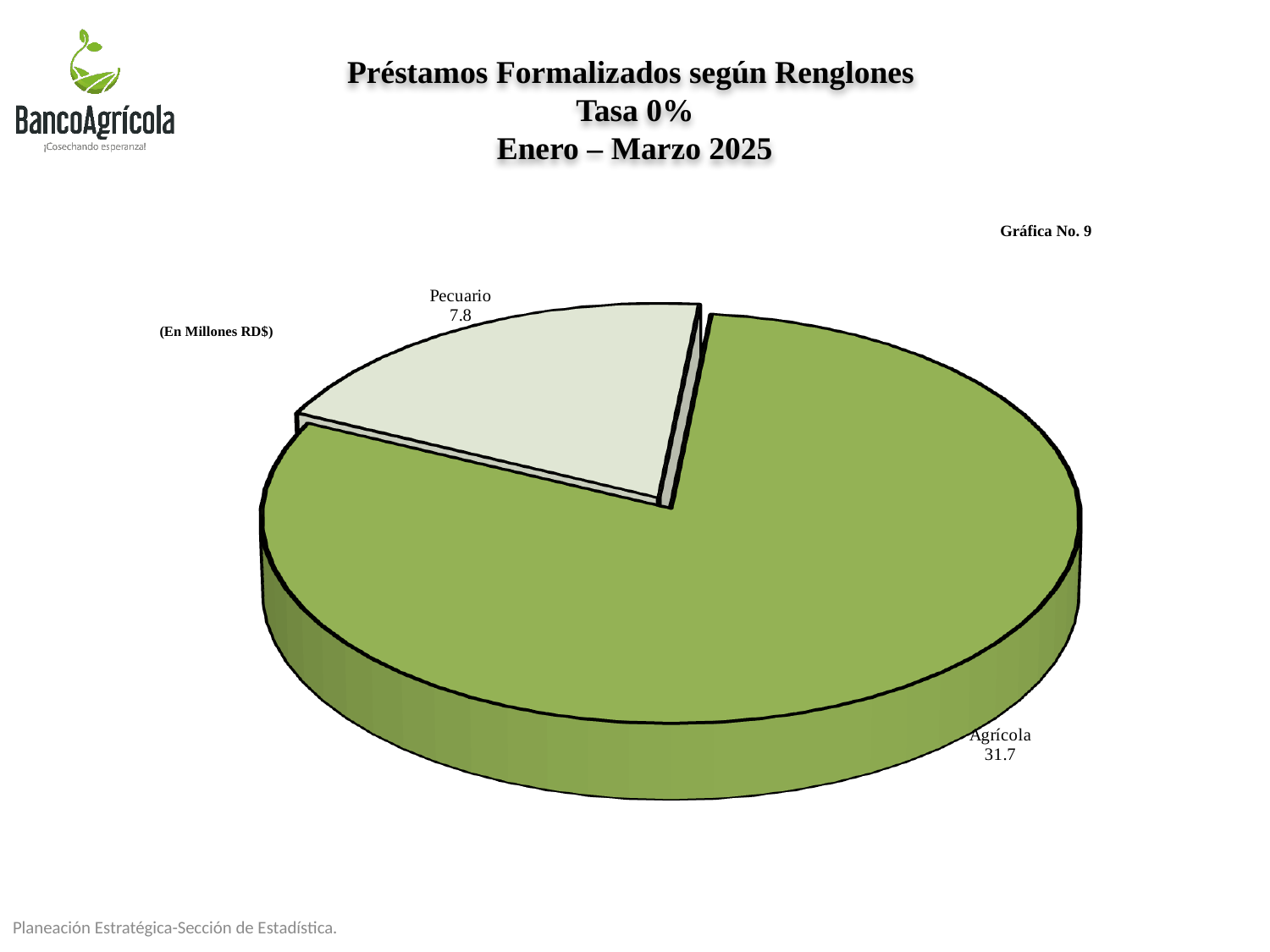
Which category has the largest slice? Agrícola Which is larger, Agrícola or Pecuario? Agrícola What is the value for Pecuario? 7.8 What kind of chart is shown on the slide? Pie chart In what units are the values expressed? En Millones RD$ What is the title of the chart? Préstamos Formalizados según Renglones Tasa 0% Enero – Marzo 2025 How many categories are shown in the pie chart? 2 Which category has the smallest slice? Pecuario What is the total of the two slices? 39.5 What is the difference between the Agrícola and Pecuario values? 23.9 What is the value for Agrícola? 31.7